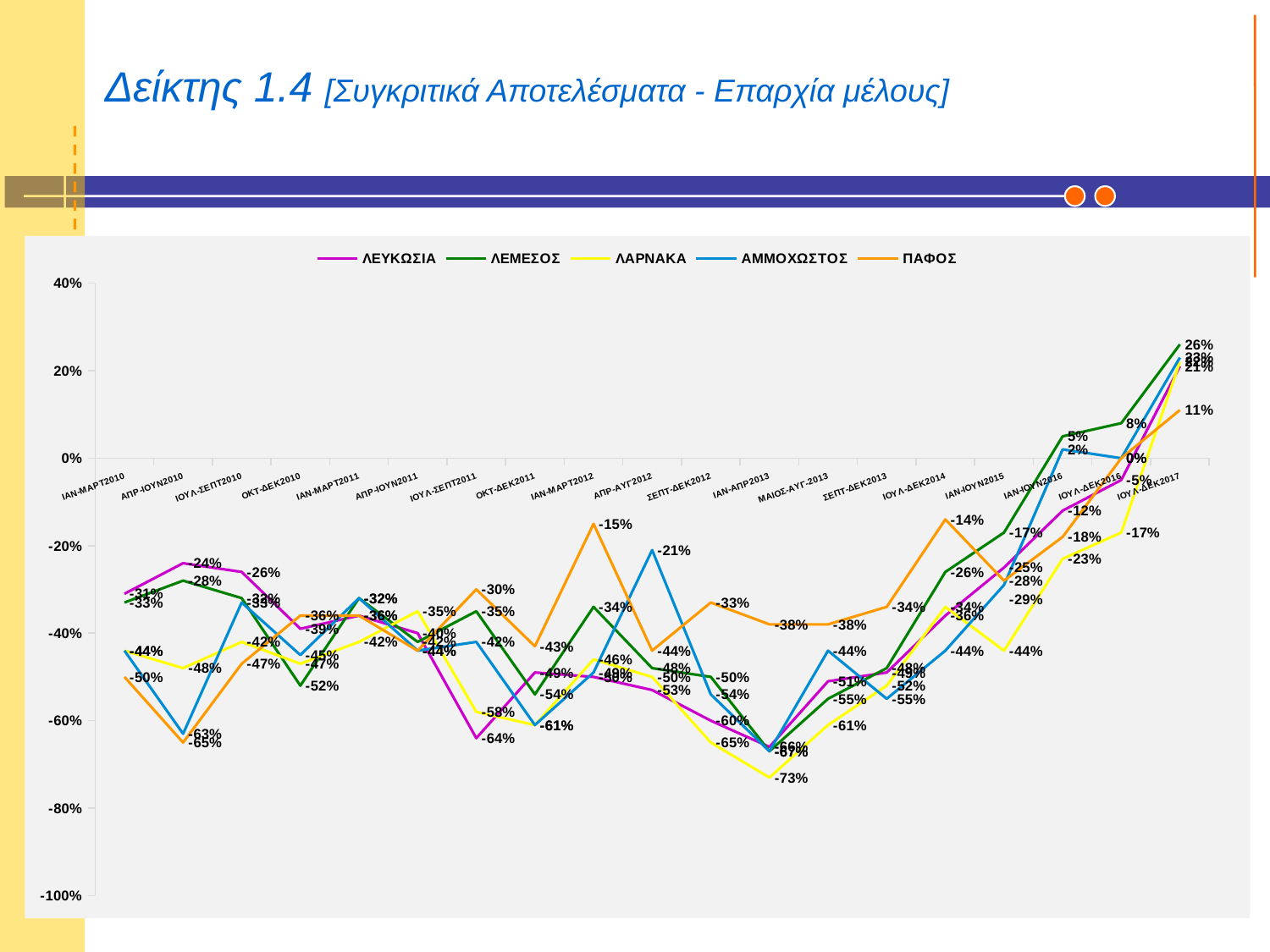
What is the value for ΠΑΦΟΣ at ΙΟΥΛ-ΔΕΚ2017? 11% Which series has the highest value at ΙΟΥΛ-ΔΕΚ2017? ΛΕΜΕΣΟΣ Which series is drawn in orange in the legend? ΠΑΦΟΣ How many series does the legend list? 5 What kind of chart is shown on the slide? Line chart Which series has the lowest value at ΜΑΙΟΣ-ΑΥΓ-2013? ΛΑΡΝΑΚΑ Is the value for ΛΑΡΝΑΚΑ at ΜΑΙΟΣ-ΑΥΓ-2013 greater or less than -60%? less What is the value for ΛΕΜΕΣΟΣ at ΙΟΥΛ-ΔΕΚ2017? 26% Does the ΛΕΜΕΣΟΣ line rise or fall from ΜΑΙΟΣ-ΑΥΓ-2013 to ΙΟΥΛ-ΔΕΚ2017? Rises What is the difference between ΛΕΜΕΣΟΣ and ΠΑΦΟΣ at ΙΟΥΛ-ΔΕΚ2017? 15 percentage points What is the value for ΠΑΦΟΣ at ΙΑΝ-ΜΑΡΤ2012? -15% What is the value for ΛΑΡΝΑΚΑ at ΜΑΙΟΣ-ΑΥΓ-2013? -61%